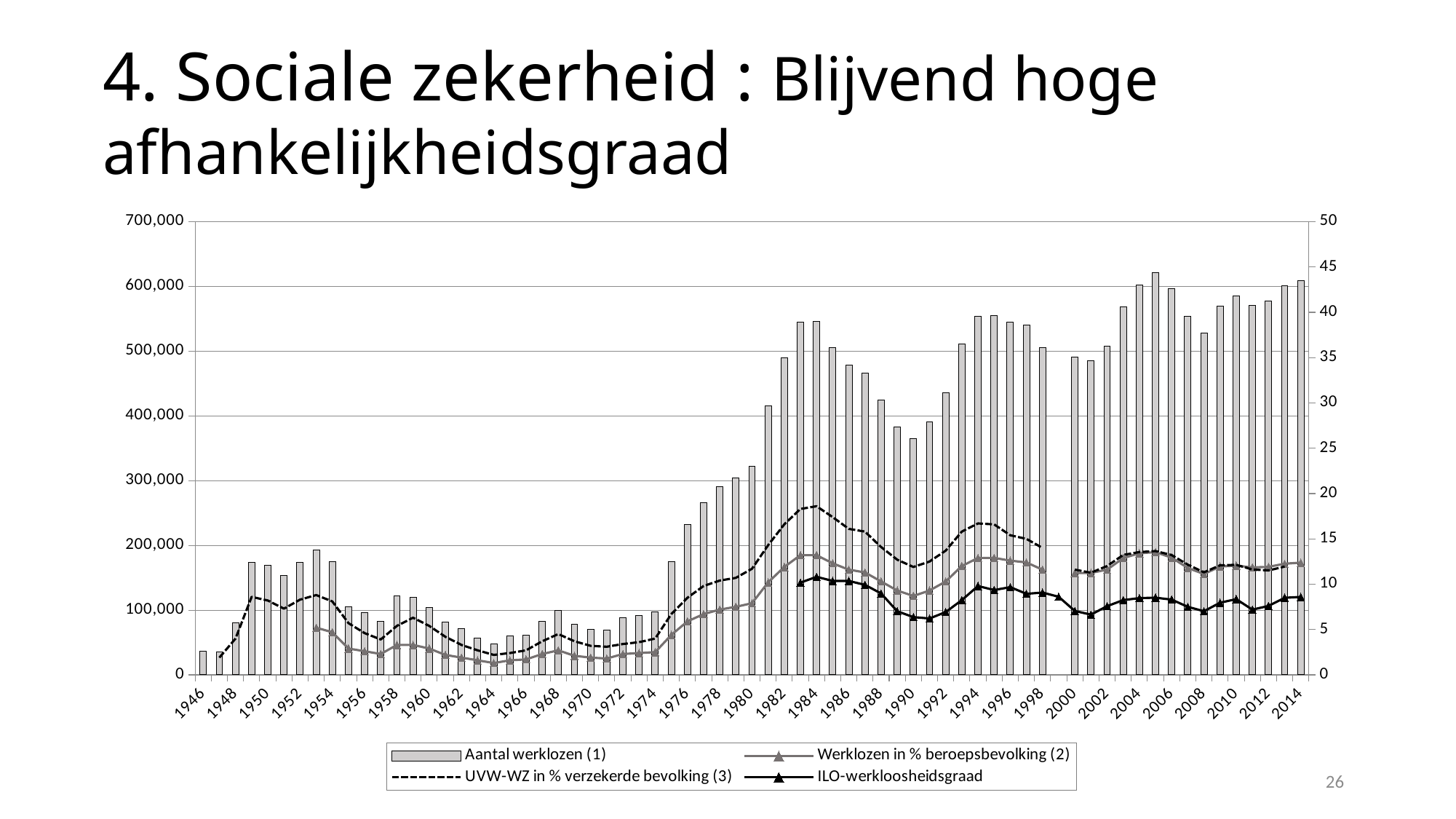
Is the value of Aantal werklozen (1) for 1990 greater or less than 400,000? less Is the value of Aantal werklozen (1) for 1946 greater or less than 100,000? less Is the value of UVW-WZ in % verzekerde bevolking (3) for 1984 greater or less than 15? greater Which is larger for Aantal werklozen (1): the value for 1984 or the value for 1990? 1984 What is the maximum value shown on the right-hand axis? 50 What kind of chart is this? Combined bar and line chart How many series does the legend list? 4 Do the values of Aantal werklozen (1) rise or fall from 1974 to 1984? rise Which series is drawn as bars? Aantal werklozen (1)